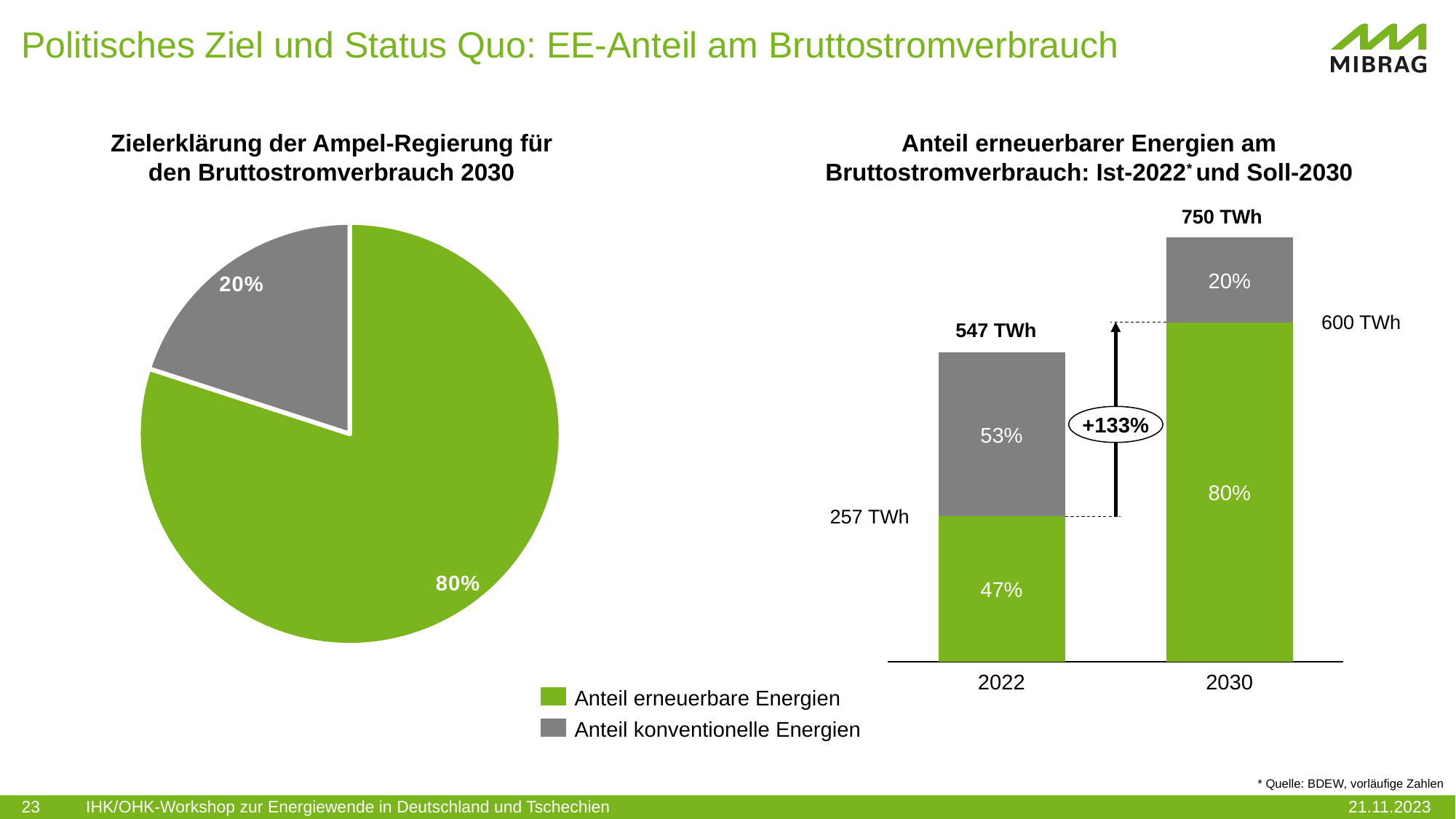
In the left pie chart, what share is shown for Anteil konventionelle Energien? 20% In the right bar chart, what is the share of Anteil konventionelle Energien in 2022? 53% How many series does the legend list? 2 In the right bar chart, what is the share of Anteil erneuerbare Energien in 2022? 47% In the right bar chart, what is the total labelled for the 2030 bar? 750 TWh In the left pie chart, what share is shown for Anteil erneuerbare Energien? 80% In the right bar chart, what percentage increase is annotated between the renewable energy amounts of 2022 and 2030? +133% In the right bar chart, what is the total labelled for the 2022 bar? 547 TWh In the right bar chart, what is the share of Anteil erneuerbare Energien in 2030? 80% What type of chart is the left chart titled 'Zielerklärung der Ampel-Regierung für den Bruttostromverbrauch 2030'? pie chart In the right bar chart, how many categories are shown on the x axis? 2 What type of chart is the right chart titled 'Anteil erneuerbarer Energien am Bruttostromverbrauch: Ist-2022 und Soll-2030'? stacked bar chart